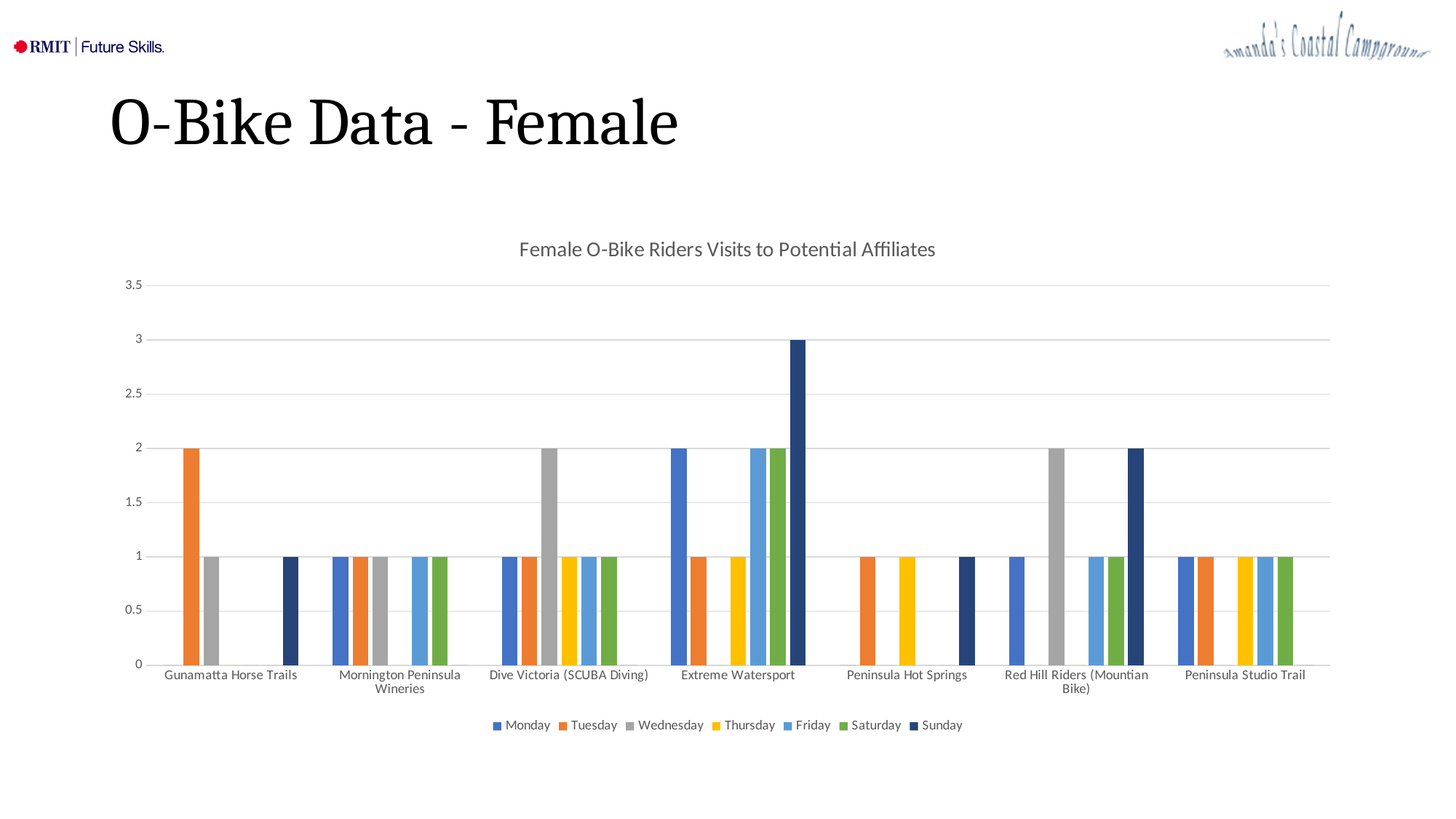
Is the Sunday value for Extreme Watersport greater or less than 2.5? greater What is the difference between the Sunday value for Extreme Watersport and the Sunday value for Peninsula Hot Springs? 2 What is the Wednesday value for Red Hill Riders (Mountian Bike)? 2 How many affiliate categories are shown on the x axis? 7 Which is larger for Dive Victoria (SCUBA Diving): the Wednesday value or the Thursday value? Wednesday Which category has the highest single bar in the chart? Extreme Watersport What is the Sunday value for Extreme Watersport? 3 What is the title of the chart? Female O-Bike Riders Visits to Potential Affiliates What is the Tuesday value for Gunamatta Horse Trails? 2 What kind of chart is shown on the slide? Bar chart How many series does the legend list? 7 Which day is shown in dark navy in the legend? Sunday